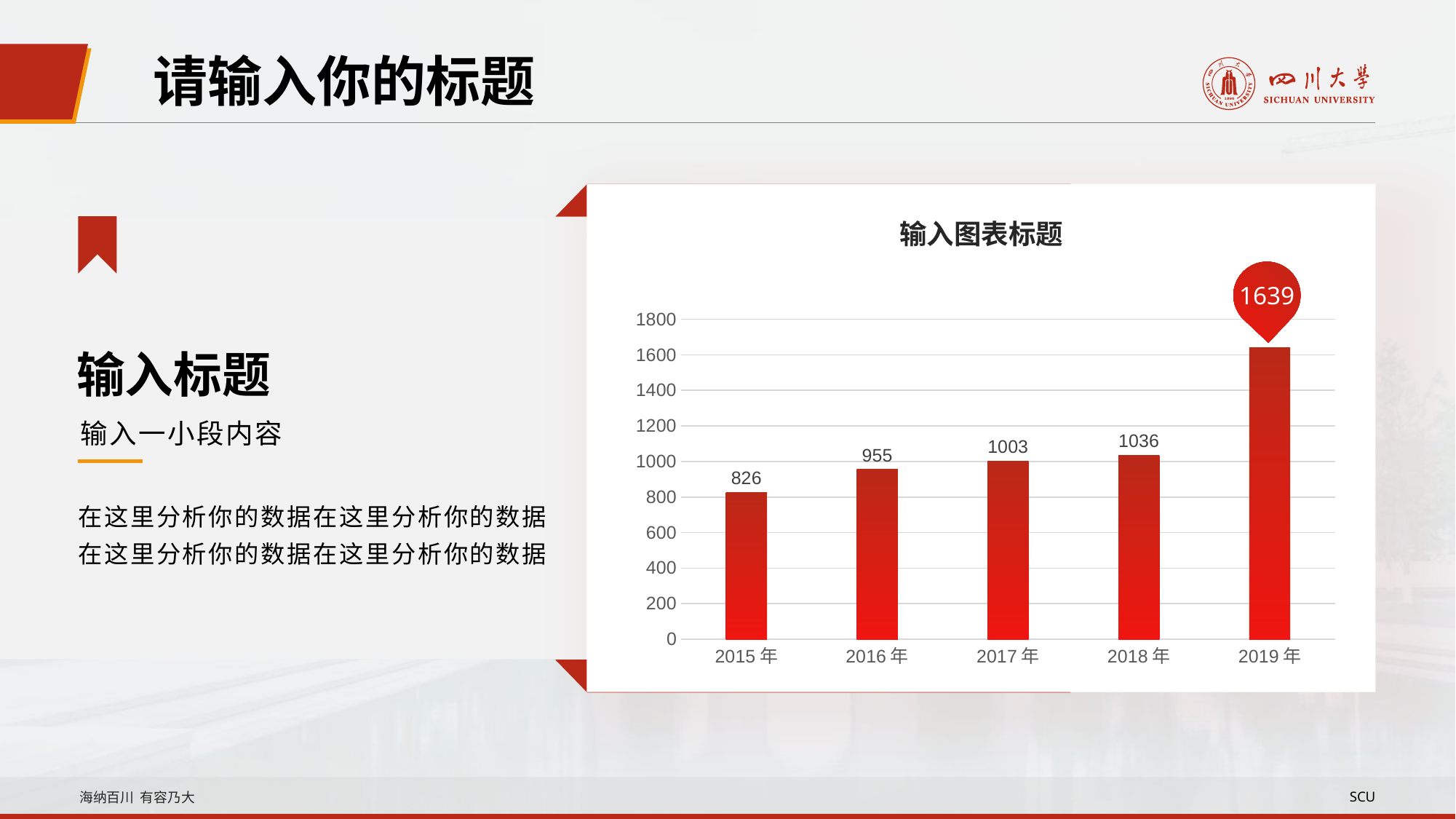
What is the value for 2017 年? 1003 What kind of chart is shown on the slide? bar chart How many years are shown on the x axis? 5 Is the value for 2018 年 greater or less than 1200? less Which year has the lowest value? 2015 年 What is the difference between the values for 2019 年 and 2018 年? 603 Do the values rise or fall from 2015 年 to 2019 年? rise Which is larger, the value for 2017 年 or the value for 2016 年? 2017 年 What is the value for 2019 年? 1639 What is the value for 2015 年? 826 What is the difference between the values for 2016 年 and 2015 年? 129 Which year has the highest value? 2019 年